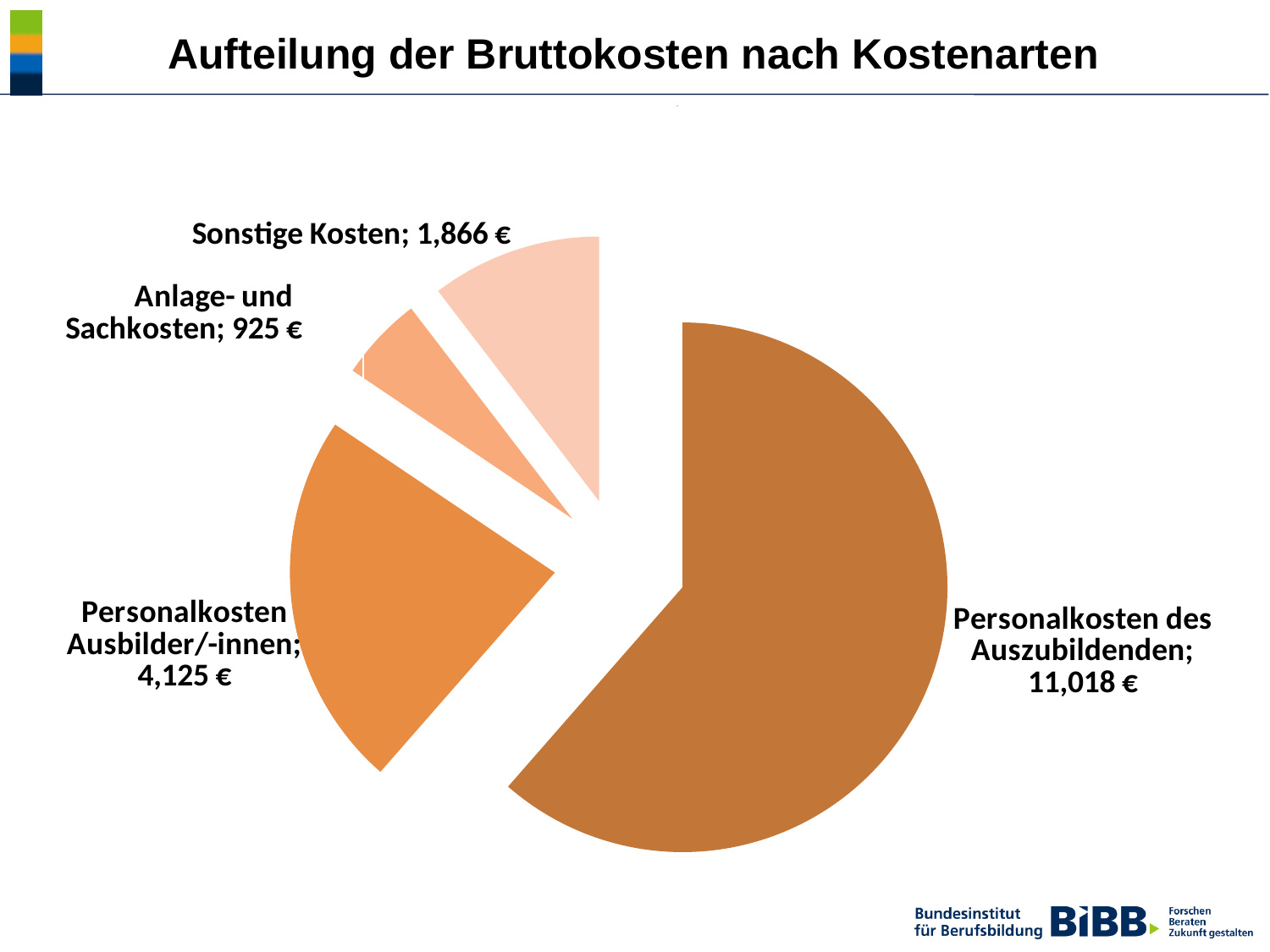
What is the difference between Personalkosten des Auszubildenden and Personalkosten Ausbilder/-innen? 6,893 € What is the difference between Sonstige Kosten and Anlage- und Sachkosten? 941 € What is the value shown for Personalkosten des Auszubildenden? 11,018 € What is the value shown for Personalkosten Ausbilder/-innen? 4,125 € What is the title of the slide? Aufteilung der Bruttokosten nach Kostenarten What is the value shown for Sonstige Kosten? 1,866 € Which is larger, Sonstige Kosten or Anlage- und Sachkosten? Sonstige Kosten What kind of chart is shown on the slide? Pie chart Which labelled cost category has the smallest value? Anlage- und Sachkosten Which labelled cost category has the largest value? Personalkosten des Auszubildenden Which is larger, Personalkosten Ausbilder/-innen or Sonstige Kosten? Personalkosten Ausbilder/-innen What is the value shown for Anlage- und Sachkosten? 925 €